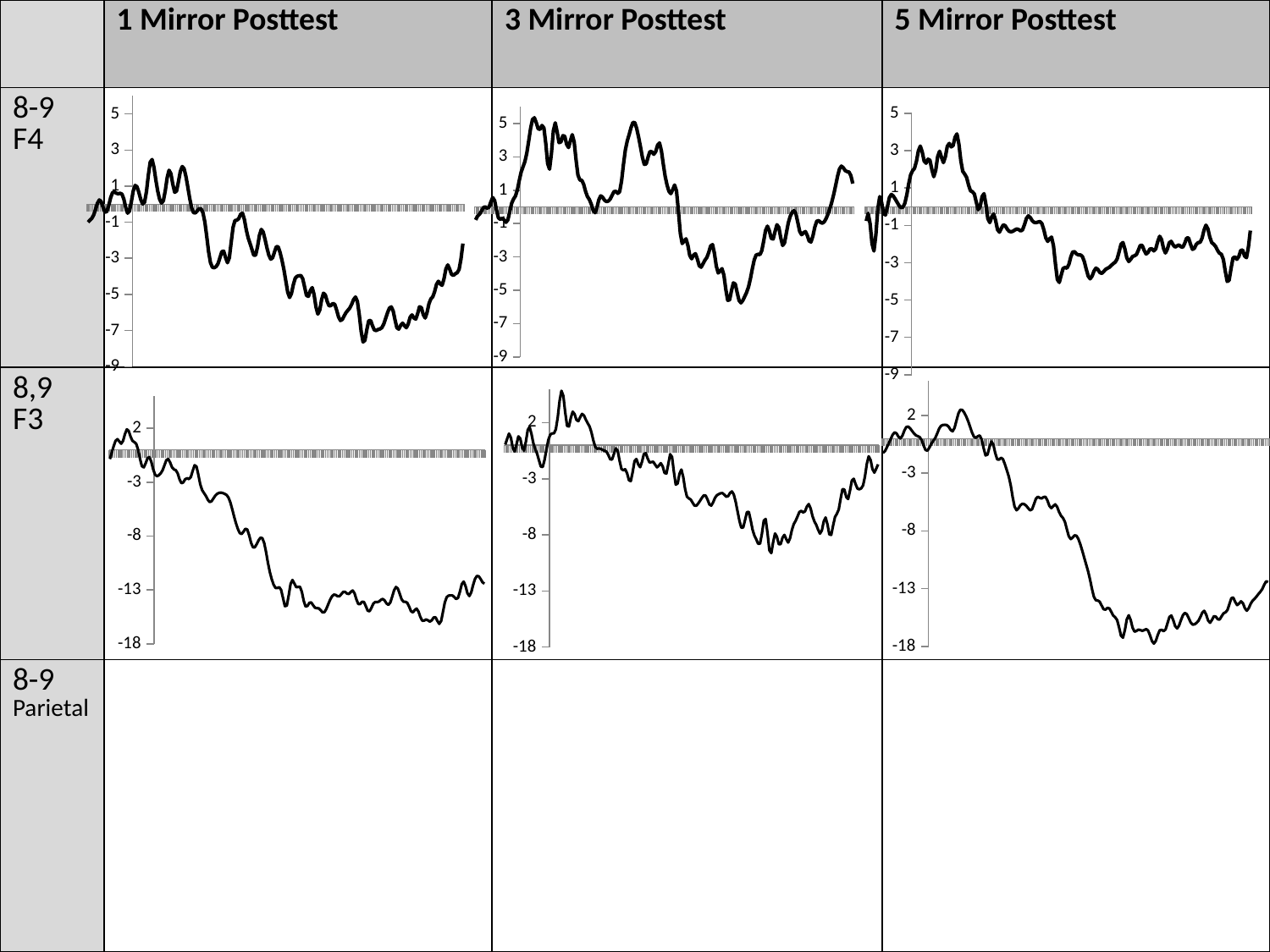
What are the three column headers above the charts? 1 Mirror Posttest, 3 Mirror Posttest, 5 Mirror Posttest What kind of chart is shown in the 8-9 F4 row under 1 Mirror Posttest? line chart How many charts with plotted lines are shown on the slide? 6 In the 8,9 F3 / 5 Mirror Posttest chart, is the lowest point of the line greater or less than -13? less In the 8,9 F3 / 5 Mirror Posttest chart, does the line end higher or lower than where it starts? lower Which row label on the slide has no charts plotted in it? 8-9 Parietal In the 8,9 F3 / 1 Mirror Posttest chart, is the lowest point of the line greater or less than -13? less In the 8-9 F4 / 5 Mirror Posttest chart, is the lowest point of the line greater or less than -7? greater In the 8-9 F4 / 1 Mirror Posttest chart, does the line mostly rise or fall after its early peak? fall